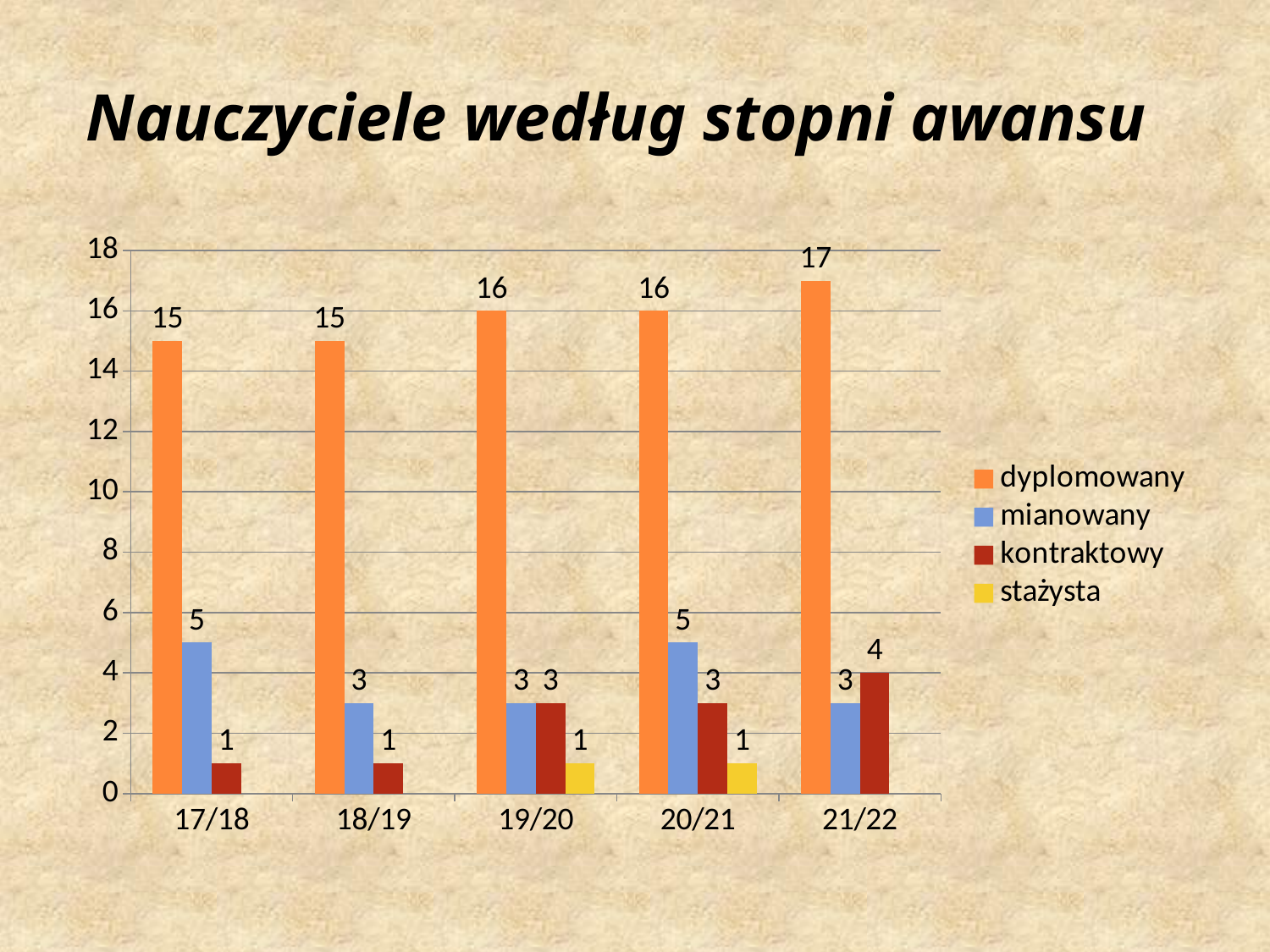
What is the title of the slide? Nauczyciele według stopni awansu In which year is the kontraktowy value highest? 21/22 How many series does the legend list? 4 What is the difference between the dyplomowany values in 21/22 and 17/18? 2 What is the value for mianowany in 17/18? 5 What kind of chart is shown? bar chart What is the value for stażysta in 19/20? 1 What is the value for kontraktowy in 21/22? 4 How many years are shown on the x axis? 5 What is the value for dyplomowany in 21/22? 17 Which is larger in 20/21: mianowany or kontraktowy? mianowany In which year is the dyplomowany value highest? 21/22